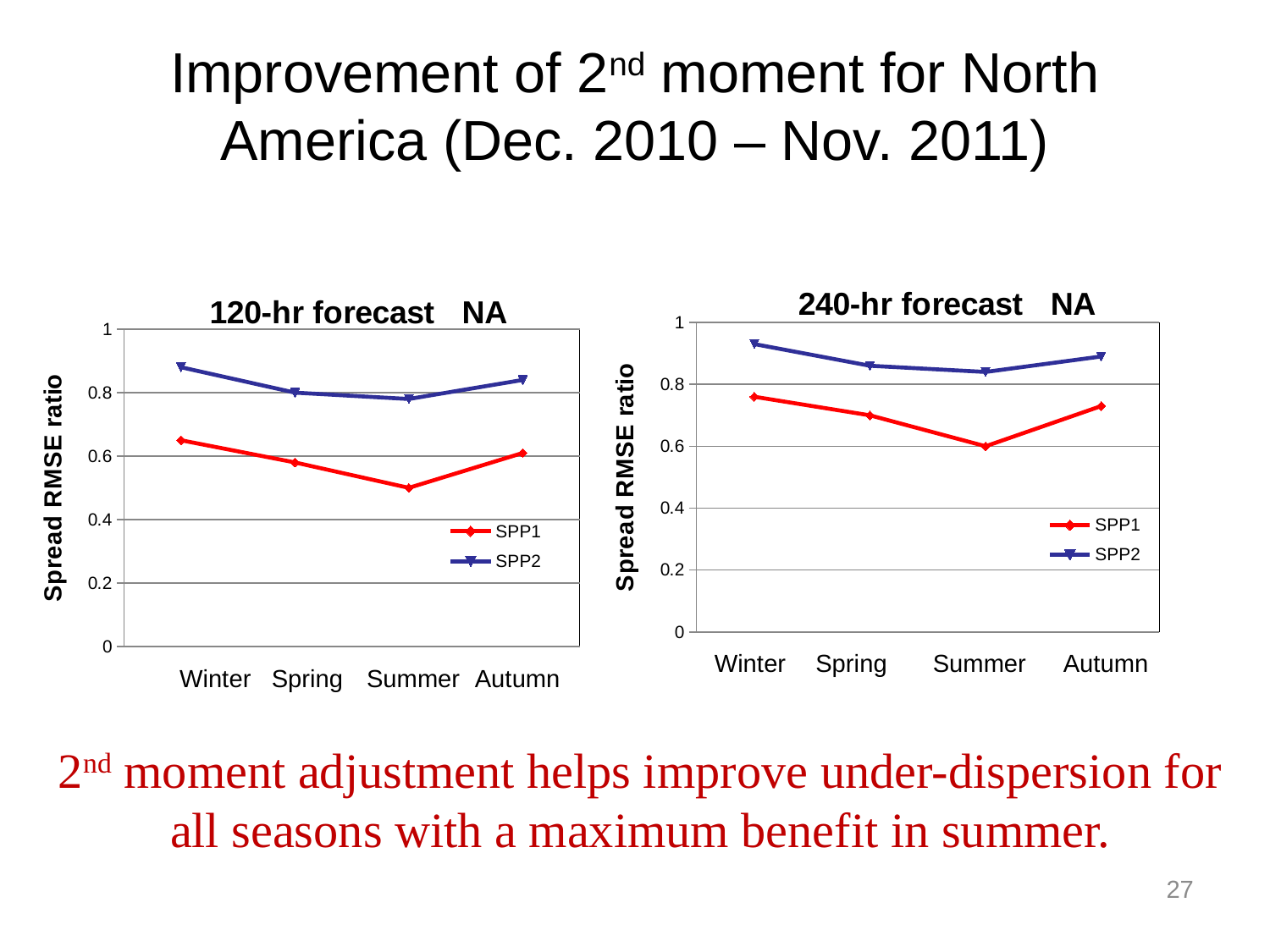
In the "120-hr forecast NA" chart, does the SPP1 line rise or fall from Winter to Summer? fall In the "120-hr forecast NA" chart, which season has the lowest SPP1 value? Summer In the "240-hr forecast NA" chart, is the SPP2 value for Winter greater or less than 0.8? greater How many seasons are shown on the x axis of the "120-hr forecast NA" chart? 4 What is the y-axis label of the "240-hr forecast NA" chart? Spread RMSE ratio In the "240-hr forecast NA" chart, which series has the larger value in Summer, SPP1 or SPP2? SPP2 In the "240-hr forecast NA" chart, which season has the lowest SPP2 value? Summer How many series does the legend of the "240-hr forecast NA" chart list? 2 What type of chart is the "120-hr forecast NA" chart? line chart In the "120-hr forecast NA" chart, is the SPP1 value for Summer greater or less than 0.6? less In the "120-hr forecast NA" chart, which season has the highest SPP2 value? Winter In the "240-hr forecast NA" chart, which season has the highest SPP1 value? Winter